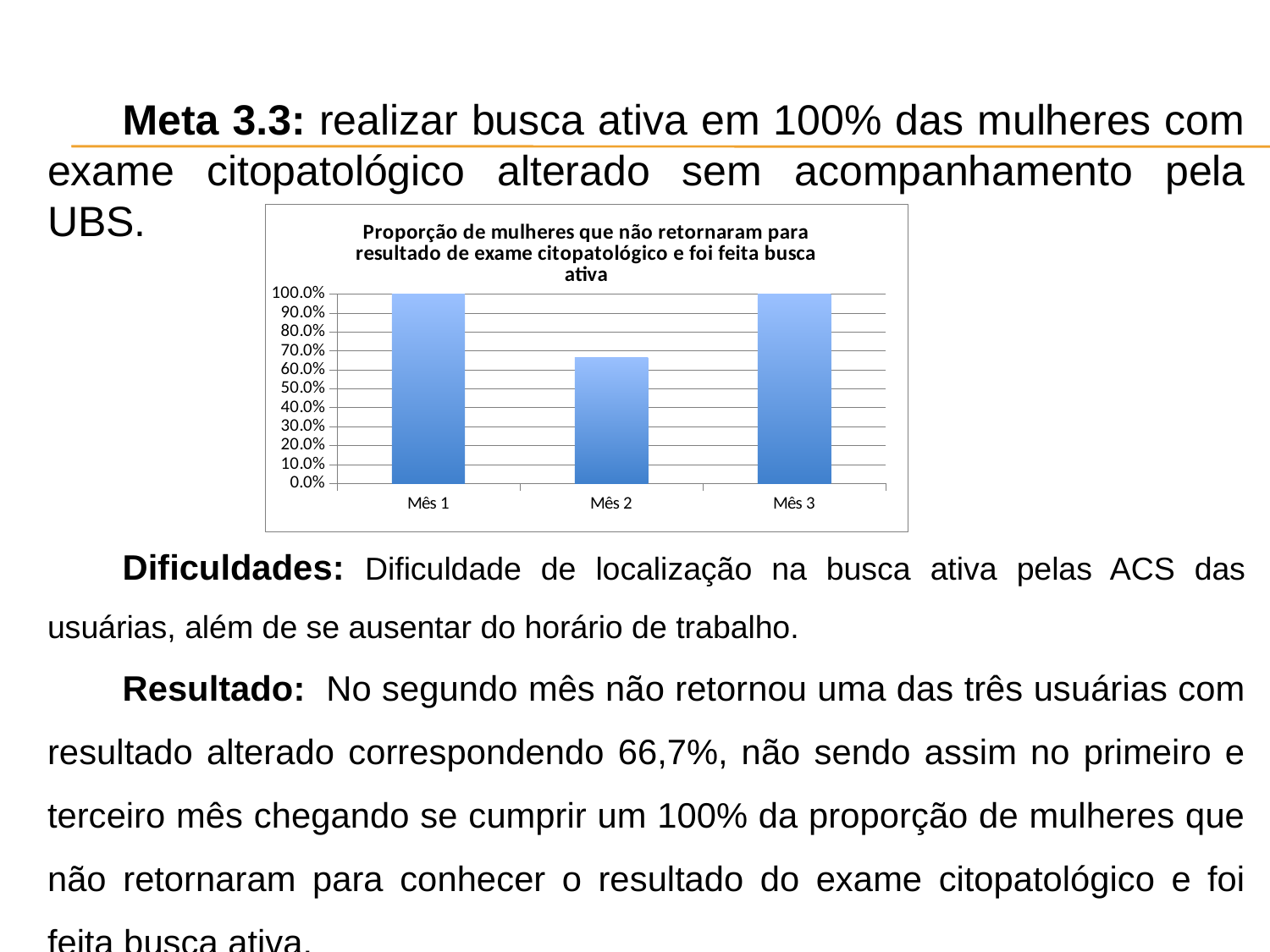
Does the value rise or fall from Mês 1 to Mês 2? fall What is the value for Mês 3? 100.0% Which is larger, the value for Mês 1 or the value for Mês 2? Mês 1 Which month has the lowest value? Mês 2 What is the highest value shown on the vertical axis of the chart? 100.0% Is the value for Mês 2 greater or less than 70.0%? less Which is larger, the value for Mês 2 or the value for Mês 3? Mês 3 Is the value for Mês 2 greater or less than 60.0%? greater How many categories (months) are plotted on the chart? 3 What is the title of the chart? Proporção de mulheres que não retornaram para resultado de exame citopatológico e foi feita busca ativa What kind of chart is shown on the slide? bar chart What is the value for Mês 1? 100.0%